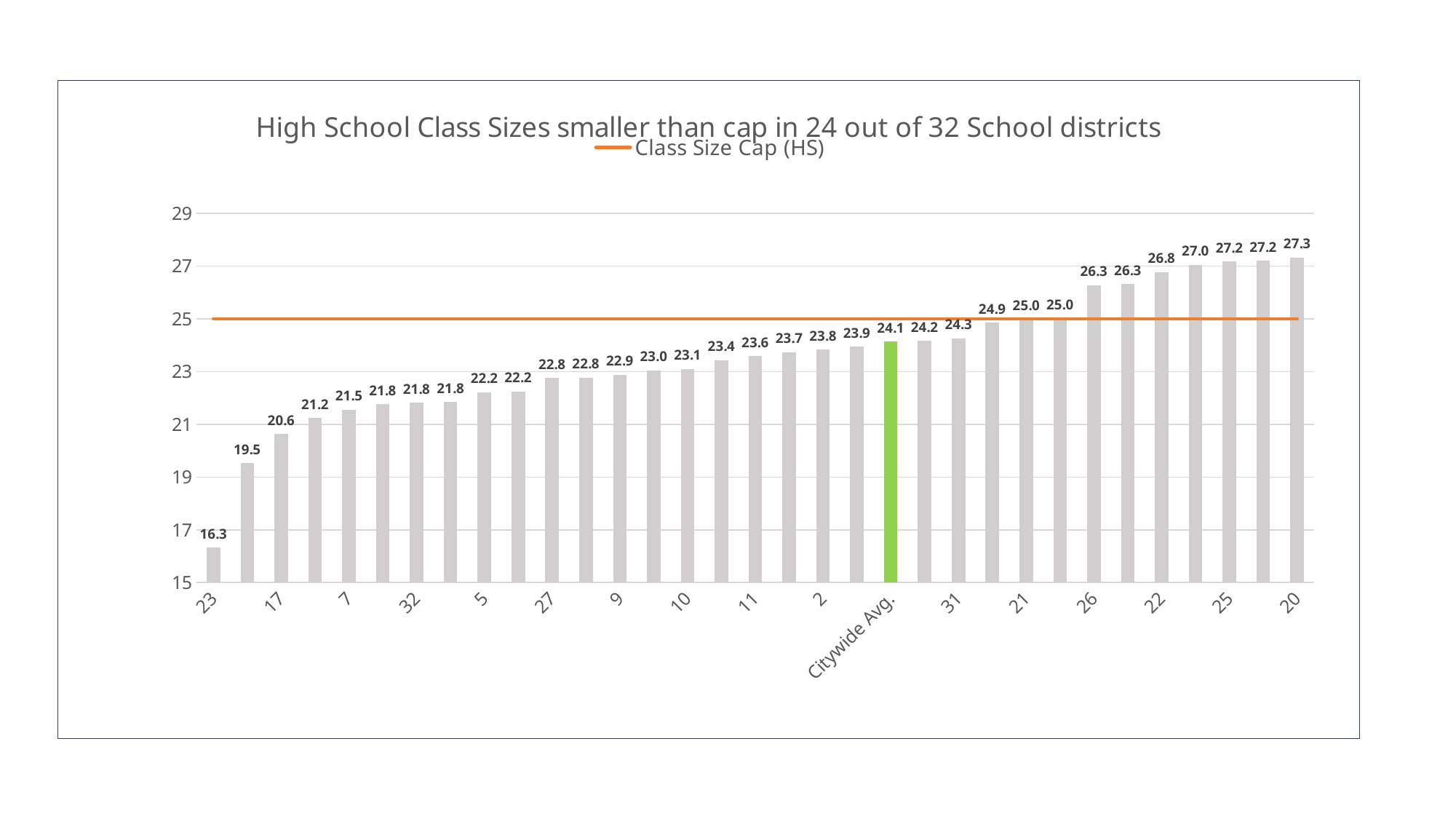
What is the value for district 20? 27.3 What kind of chart is shown on the slide? combination bar and line chart Which is larger, the value for district 7 or the value for district 17? 7 What is the value for Citywide Avg.? 24.1 What is the name of the line series shown in the legend? Class Size Cap (HS) What is the value for district 17? 20.6 What is the difference between the values for district 20 and district 23? 11.0 What is the value for district 23? 16.3 Is the value for district 26 greater or less than 25? greater Which labeled category has the lowest value? 23 Which labeled category has the highest value? 20 How many bars are plotted in the chart? 33